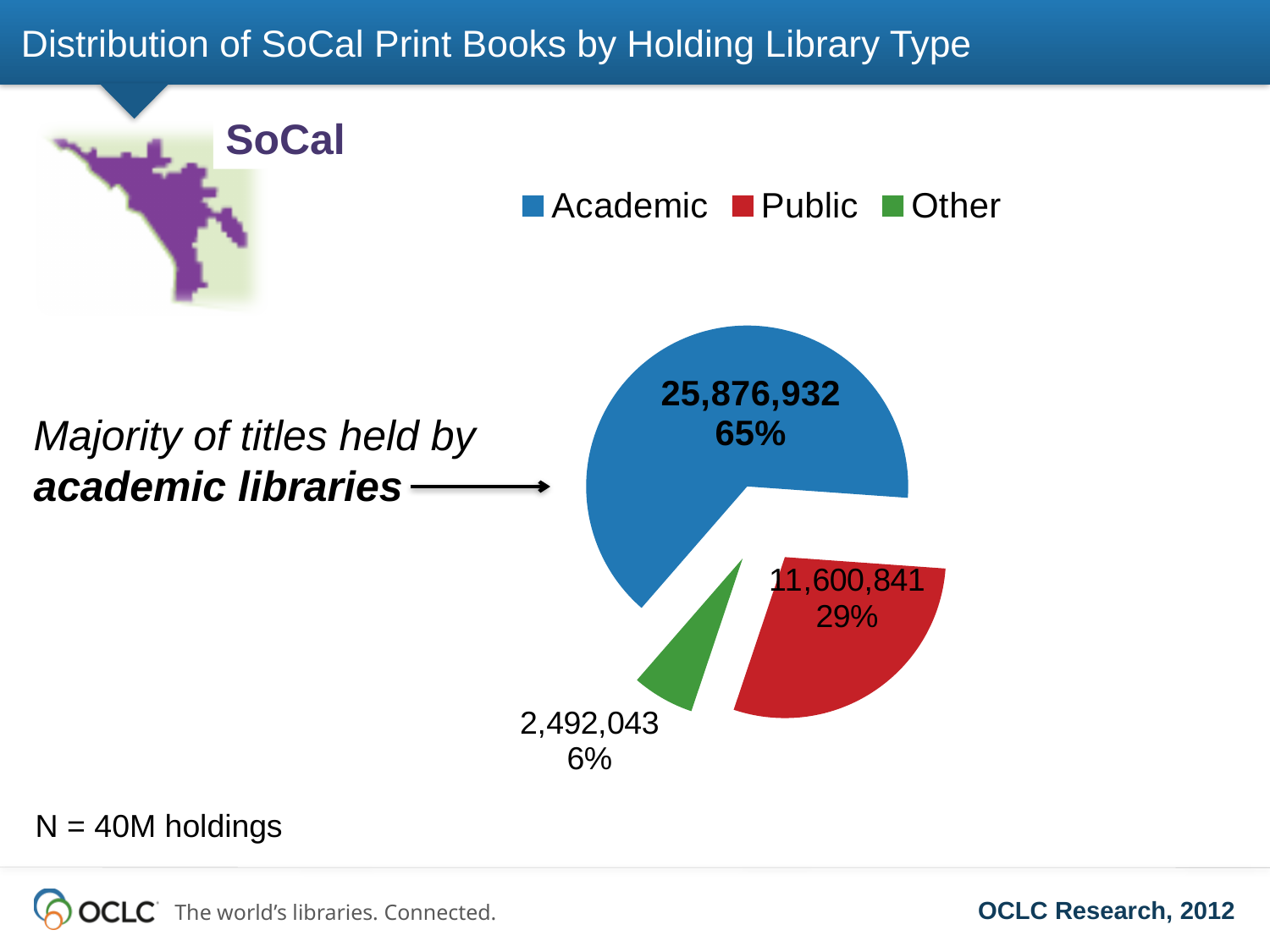
Which has more holdings, Public or Other libraries? Public How many slices does the pie chart have? 3 Which library type holds the largest share of SoCal print books? Academic What kind of chart is shown on the slide? pie chart How many holdings does the Public slice represent? 11,600,841 How many holdings does the Academic slice represent? 25,876,932 What share of the pie is the Other slice? 6% What share of the pie is the Public slice? 29% Which library type holds the smallest share of SoCal print books? Other How many holdings does the Other slice represent? 2,492,043 What is the difference in holdings between Academic and Public libraries? 14,276,091 What colour is the Academic slice in the pie chart? blue